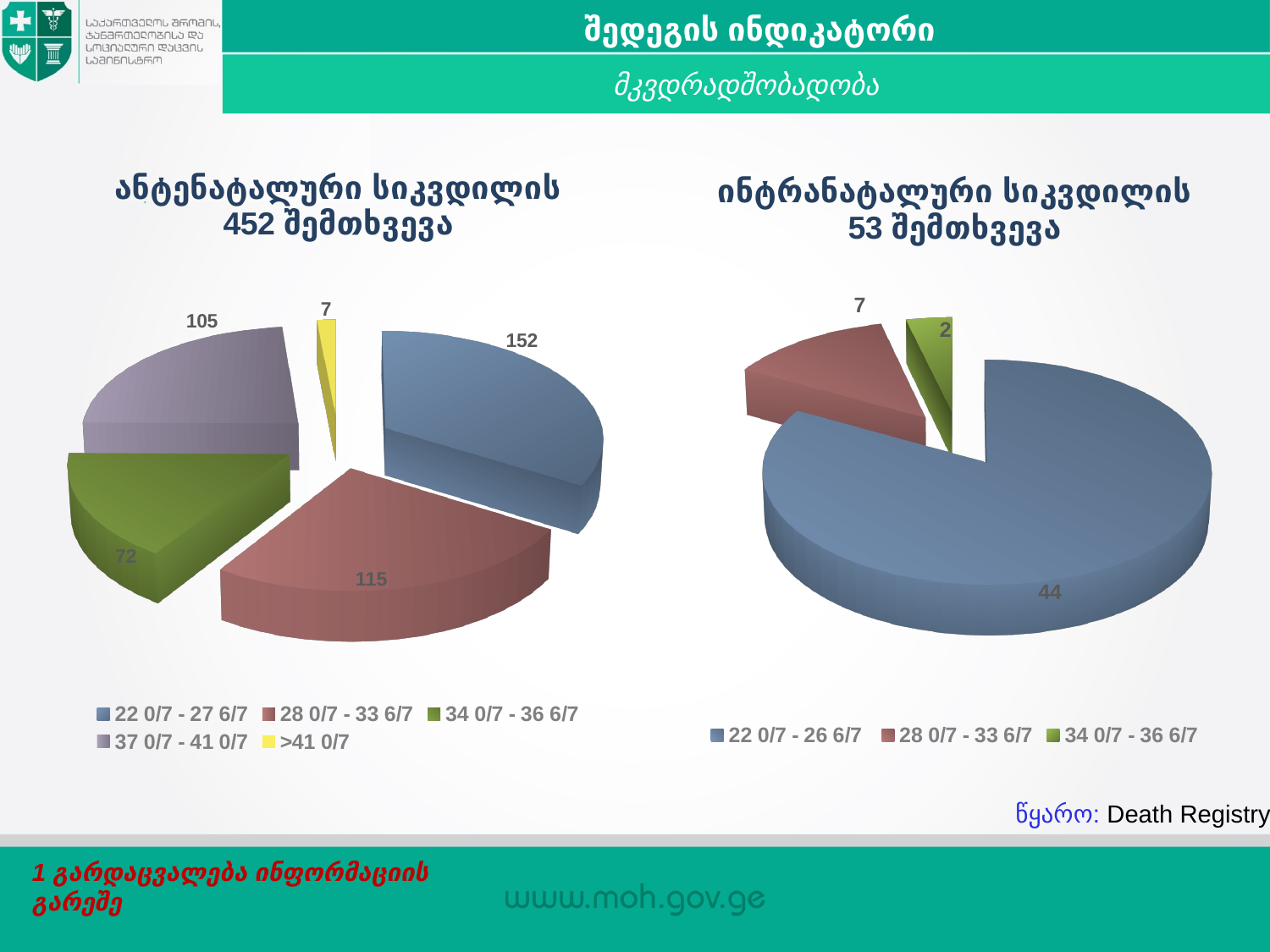
What type of chart is used on the right side of the slide? Pie chart On the right pie chart (ინტრანატალური სიკვდილის 53 შემთხვევა), what is the value for the 22 0/7 - 26 6/7 slice? 44 On the left pie chart, what is the value for the >41 0/7 slice? 7 On the right pie chart, what is the value for the 34 0/7 - 36 6/7 slice? 2 On the left pie chart, how many categories does the legend list? 5 On the left pie chart (ანტენატალური სიკვდილის 452 შემთხვევა), what is the value for the 22 0/7 - 27 6/7 slice? 152 On the left pie chart, what is the difference between the 28 0/7 - 33 6/7 slice and the 37 0/7 - 41 0/7 slice? 10 On the left pie chart, which category has the largest slice? 22 0/7 - 27 6/7 On the left pie chart, which category has the smallest slice? >41 0/7 On the right pie chart, what is the total of all slices? 53 On the right pie chart, which is larger: the 28 0/7 - 33 6/7 slice or the 34 0/7 - 36 6/7 slice? 28 0/7 - 33 6/7 On the left pie chart, what is the value for the 34 0/7 - 36 6/7 slice? 72